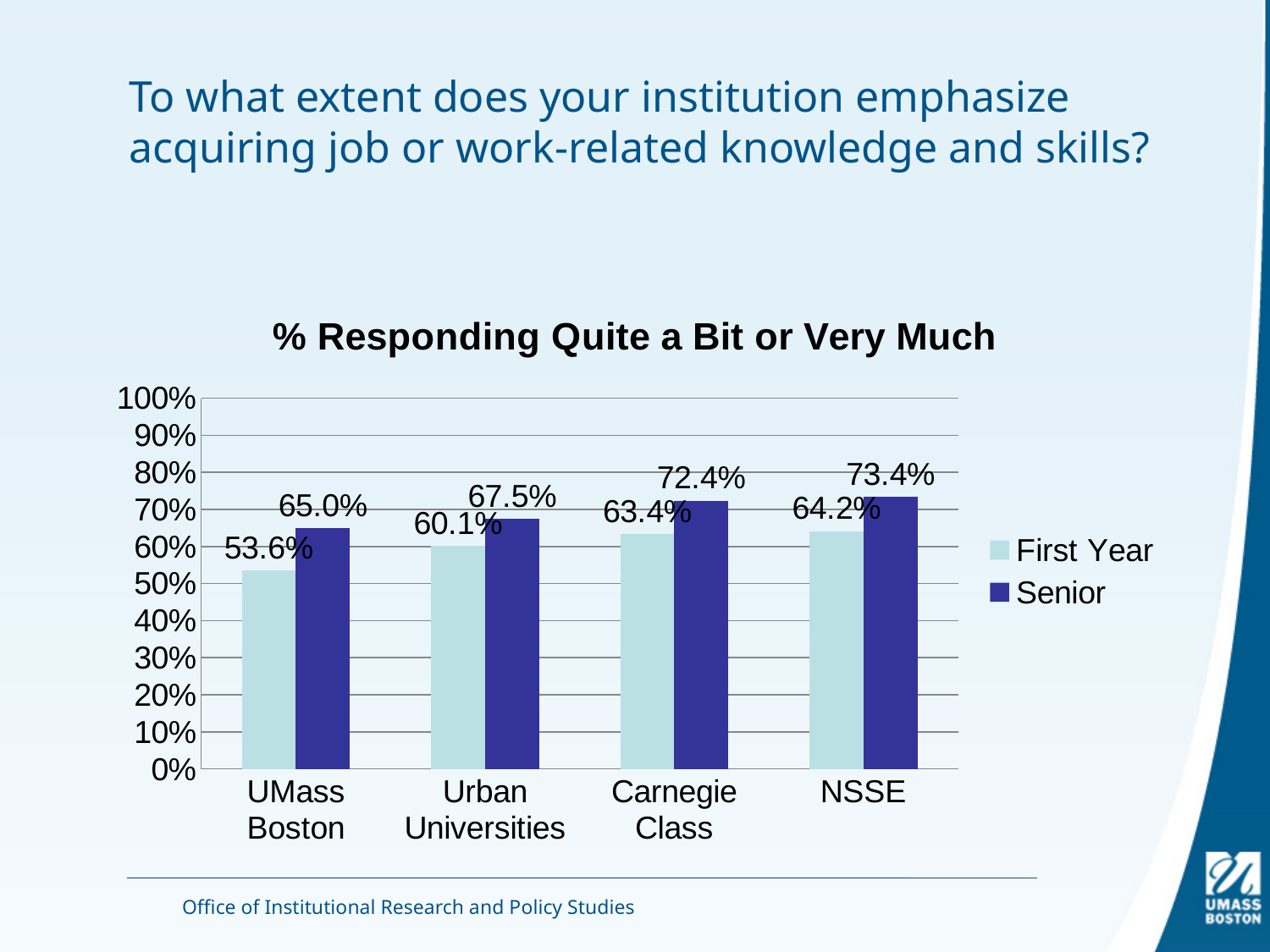
Which category has the highest Senior value? NSSE How many series does the legend list? 2 What is the First Year value for NSSE? 64.2% Which category has the lowest First Year value? UMass Boston Which is larger, the First Year value for Carnegie Class or the First Year value for Urban Universities? Carnegie Class What kind of chart is shown on the slide? Bar chart How many categories are shown on the x axis? 4 What is the Senior value for Urban Universities? 67.5% What is the First Year value for UMass Boston? 53.6% What is the difference between the Senior and First Year values for UMass Boston? 11.4% What is the title of the chart? % Responding Quite a Bit or Very Much What is the Senior value for Carnegie Class? 72.4%